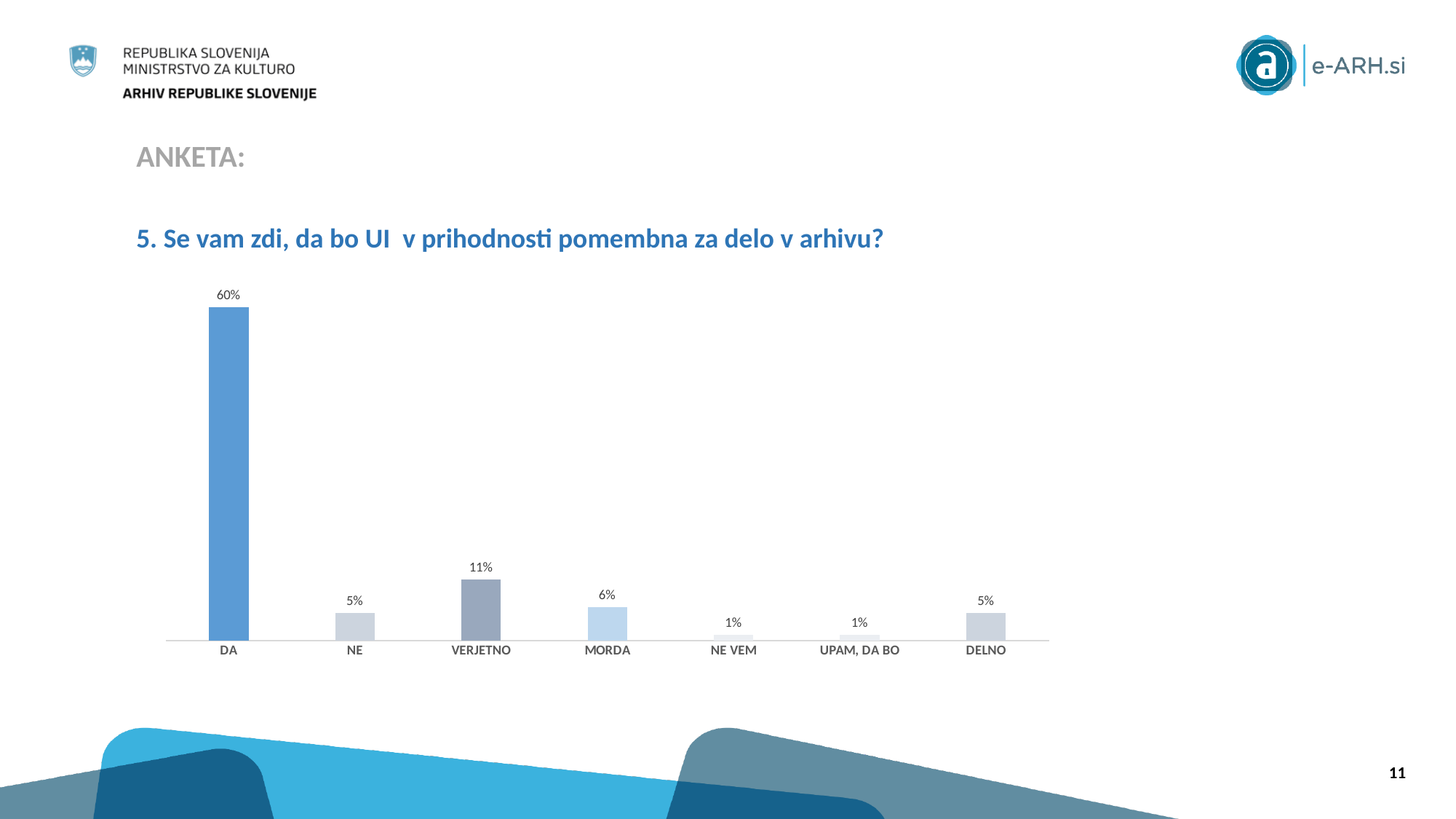
What is the value for DELNO? 5% What is the value for MORDA? 6% How many categories are shown on the x axis? 7 Which is larger, the value for MORDA or the value for NE VEM? MORDA What is the difference between the values for DA and VERJETNO? 49% Which category has the highest value? DA What is the survey question shown above the chart? 5. Se vam zdi, da bo UI v prihodnosti pomembna za delo v arhivu? Which is larger, the value for NE or the value for VERJETNO? VERJETNO What kind of chart is shown on the slide? Bar chart What is the value for DA? 60% What is the difference between the values for VERJETNO and MORDA? 5% What is the value for VERJETNO? 11%